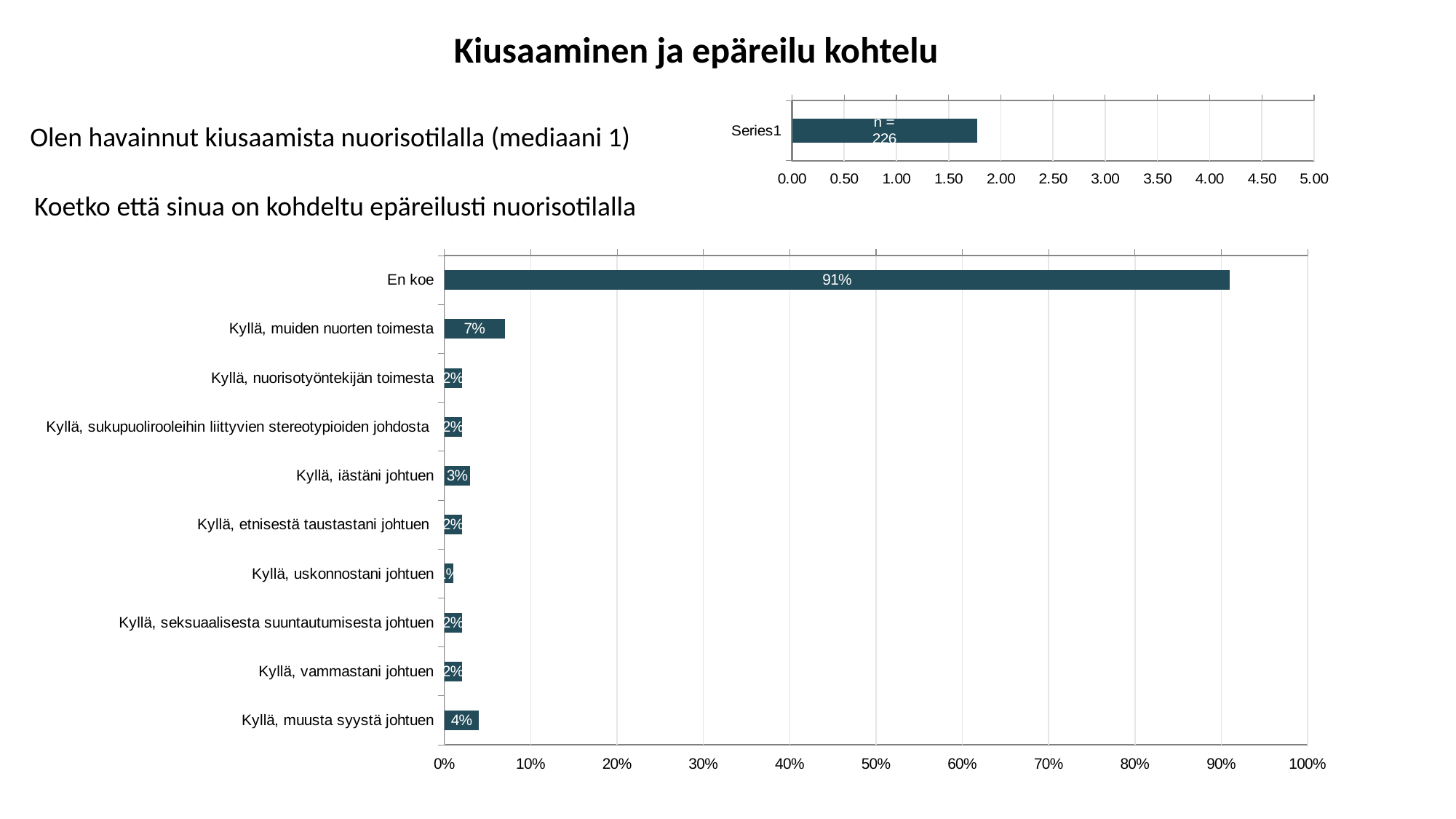
In the bottom chart, what is the value for "En koe"? 91% In the bottom chart, what is the value for "Kyllä, muusta syystä johtuen"? 4% How many categories does the bottom chart show? 10 In the bottom chart, what is the value for "Kyllä, iästäni johtuen"? 3% What kind of chart is the bottom chart? bar chart In the bottom chart, what is the value for "Kyllä, muiden nuorten toimesta"? 7% In the bottom chart, what is the difference between "En koe" and "Kyllä, muiden nuorten toimesta"? 84% In the top-right chart, is the value for Series1 greater or less than 1.50? greater In the bottom chart, is the value for "En koe" greater or less than 90%? greater In the bottom chart, which is larger: "Kyllä, muusta syystä johtuen" or "Kyllä, iästäni johtuen"? Kyllä, muusta syystä johtuen What is the title of the slide? Kiusaaminen ja epäreilu kohtelu In the bottom chart, which category has the highest value? En koe